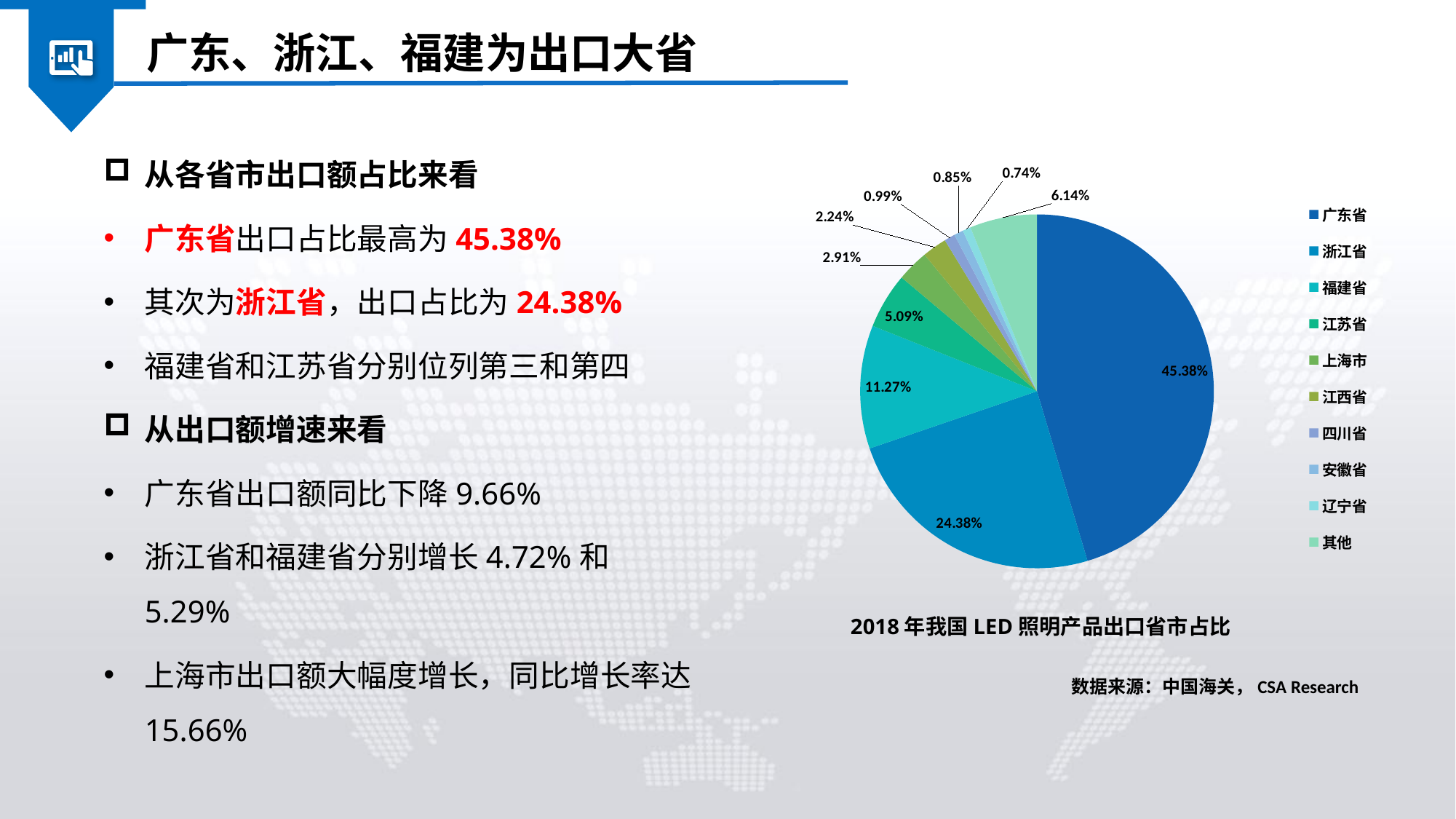
Which category has the smallest slice of the pie? 辽宁省 What is the value shown for 福建省? 11.27% What is the title of the chart? 2018年我国LED照明产品出口省市占比 Which is larger, the share of 上海市 or the share of 江西省? 上海市 Which category has the largest slice of the pie? 广东省 What is the value shown for 其他? 6.14% What is the difference between the shares of 广东省 and 浙江省? 21.00% How many categories does the legend of the pie chart list? 10 What is the value shown for 江苏省? 5.09% What kind of chart is shown on the slide? pie chart What is the value shown for 浙江省? 24.38% What share of the pie does 广东省 hold? 45.38%